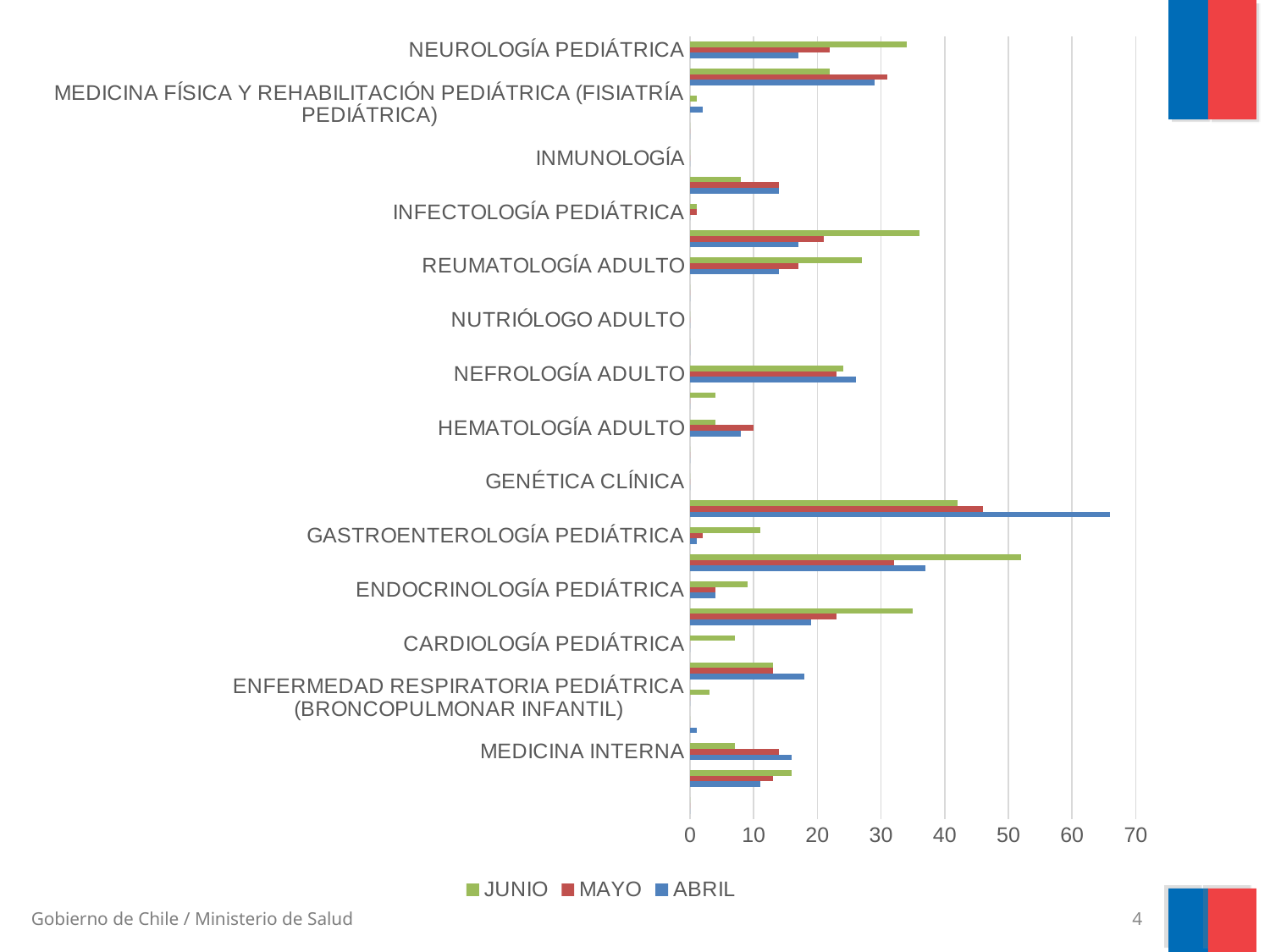
What kind of chart is shown on the slide? bar chart What is the highest value shown on the horizontal axis? 70 How many series does the legend list? 3 Which series is listed first in the legend? JUNIO Which series has the single longest bar in the chart? ABRIL Is the longest bar in the chart greater or less than 60? greater Which series is shown in blue? ABRIL